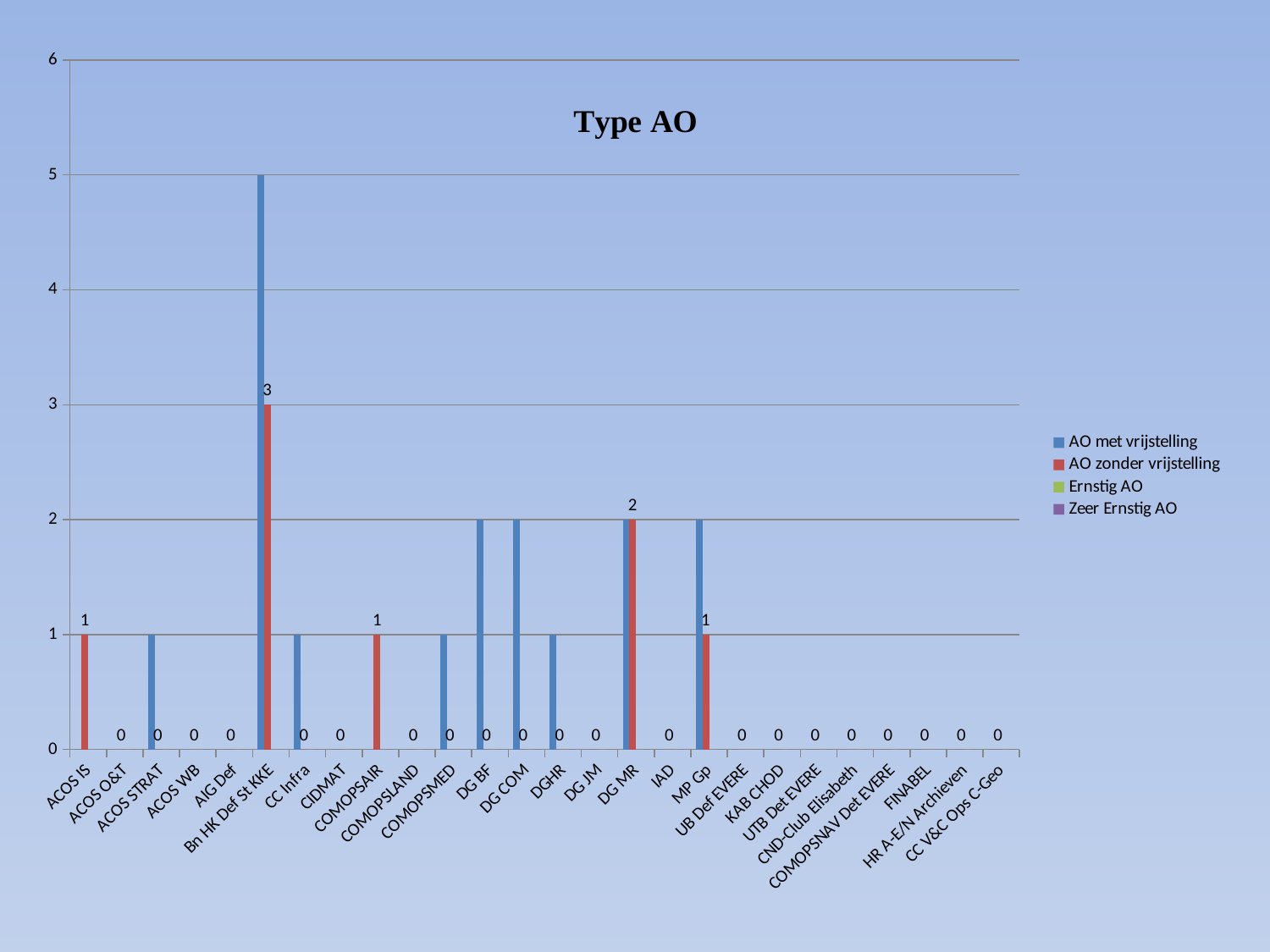
What is the value of AO zonder vrijstelling for COMOPSAIR? 1 What is the value of AO zonder vrijstelling for Bn HK Def St KKE? 3 What is the value of AO zonder vrijstelling for DG MR? 2 What kind of chart is shown on the slide? Bar chart How many series does the legend list? 4 What is the difference between AO met vrijstelling and AO zonder vrijstelling for Bn HK Def St KKE? 2 For MP Gp, which is larger: AO met vrijstelling or AO zonder vrijstelling? AO met vrijstelling What is the value of AO met vrijstelling for Bn HK Def St KKE? 5 Which category has the highest value for AO met vrijstelling? Bn HK Def St KKE How many categories are shown on the x axis? 26 Which category has the highest value for AO zonder vrijstelling? Bn HK Def St KKE What is the title of the chart? Type AO